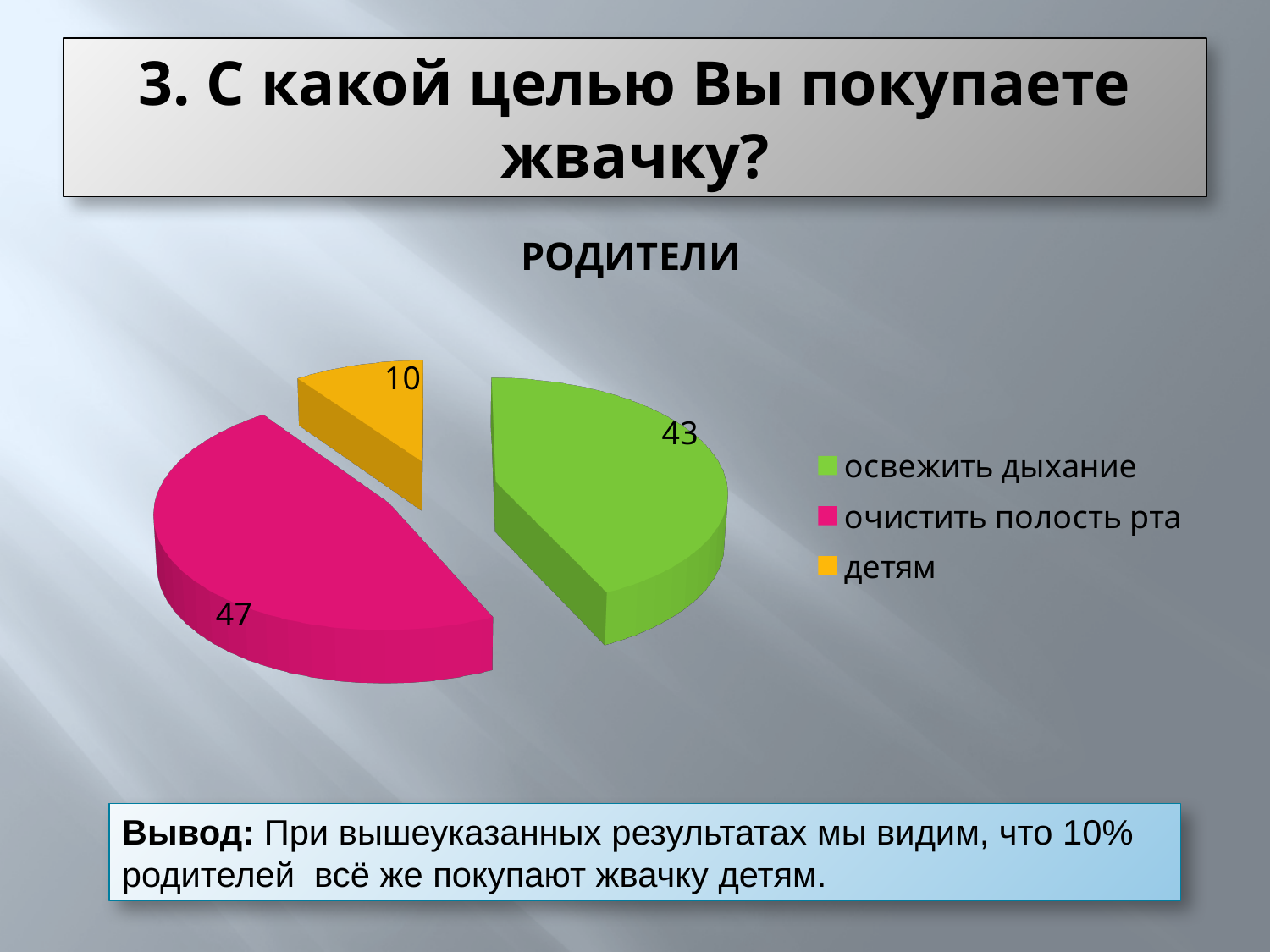
What is the difference between the values for "освежить дыхание" and "детям"? 33 How many slices does the pie chart have? 3 Which is larger: the value for "освежить дыхание" or the value for "детям"? освежить дыхание What is the difference between the values for "очистить полость рта" and "освежить дыхание"? 4 What value is shown for the slice "детям"? 10 What value is shown for the slice "очистить полость рта"? 47 What value is shown for the slice "освежить дыхание"? 43 What is the title of the chart? РОДИТЕЛИ What kind of chart is shown on the slide? pie chart What colour is the slice for "детям"? yellow Which category has the smallest slice of the pie? детям Which category has the largest slice of the pie? очистить полость рта